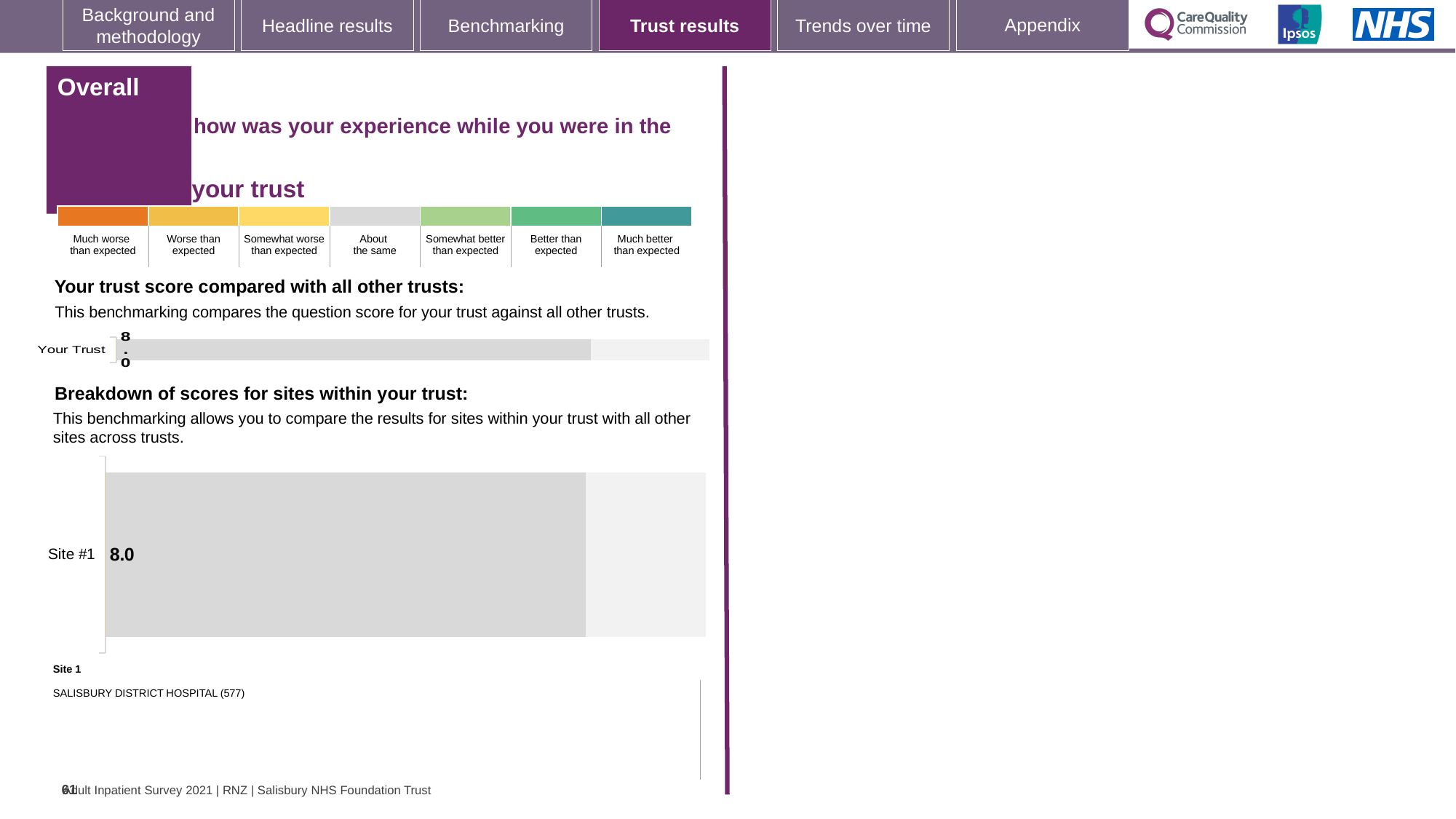
What kind of chart is the 'Breakdown of scores for sites within your trust' chart? bar chart How many categories are plotted in the 'Your trust score compared with all other trusts' chart? 1 How many sites are plotted in the 'Breakdown of scores for sites within your trust' chart? 1 In the 'Breakdown of scores for sites within your trust' chart, what is the value for Site #1? 8.0 What is the difference between the Site #1 value in the site breakdown chart and the Your Trust value in the trust comparison chart? 0.0 What kind of chart is the 'Your trust score compared with all other trusts' chart? bar chart In the 'Your trust score compared with all other trusts' chart, what is the value for Your Trust? 8.0 What is the label of the single bar in the 'Breakdown of scores for sites within your trust' chart? Site #1 What is the label of the single bar in the 'Your trust score compared with all other trusts' chart? Your Trust